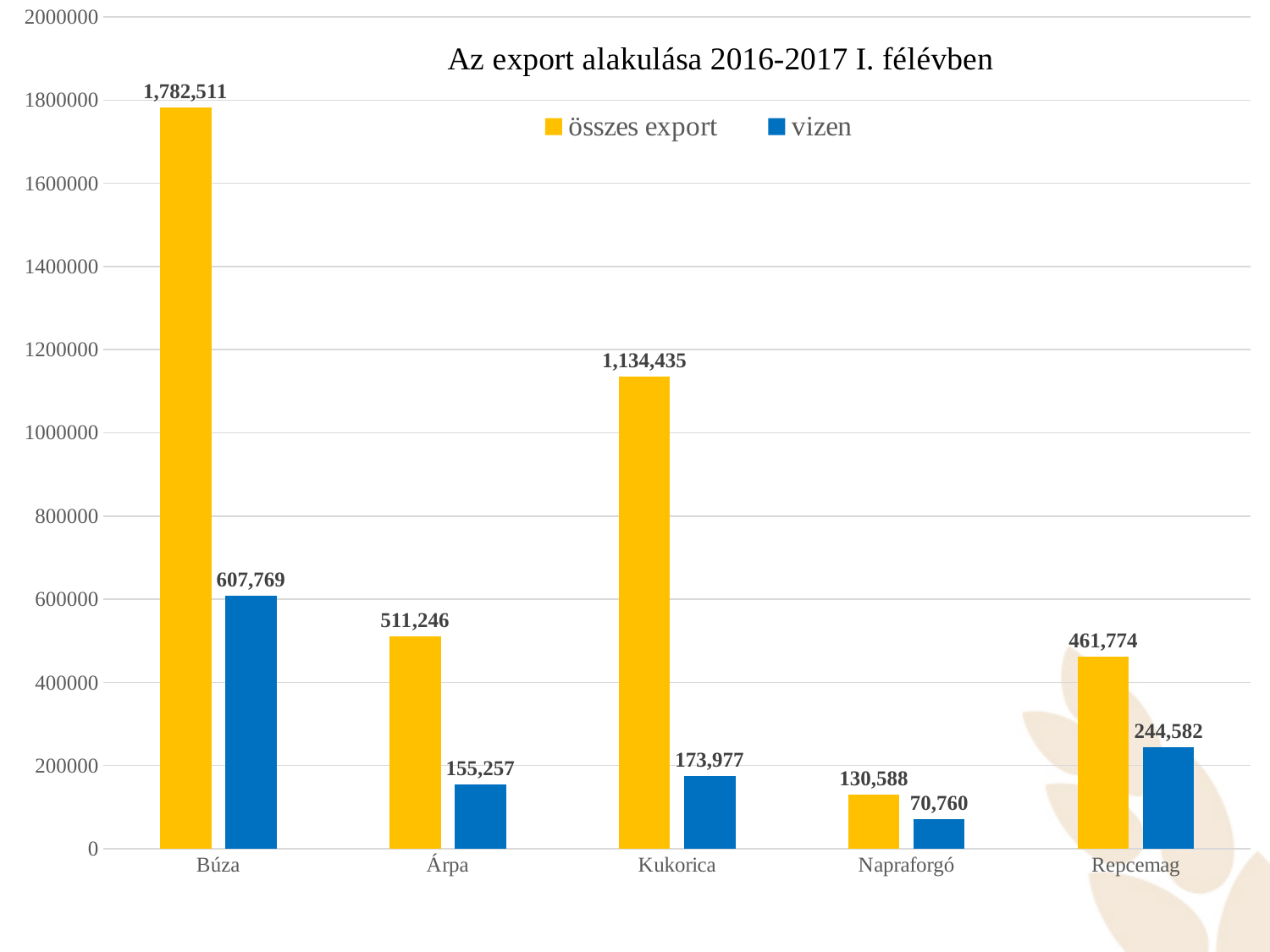
Which is larger, the vizen value for Kukorica or the vizen value for Árpa? Kukorica How many series does the legend list? 2 What is the difference between the összes export and vizen values for Búza? 1,174,742 How many categories are shown on the x axis? 5 What is the összes export value for Napraforgó? 130,588 What is the vizen value for Repcemag? 244,582 Which category has the lowest vizen value? Napraforgó Is the összes export value for Kukorica greater or less than 1000000? greater Which category has the highest összes export value? Búza What is the difference between the összes export values for Árpa and Repcemag? 49,472 What is the összes export value for Búza? 1,782,511 What type of chart is shown on the slide? bar chart